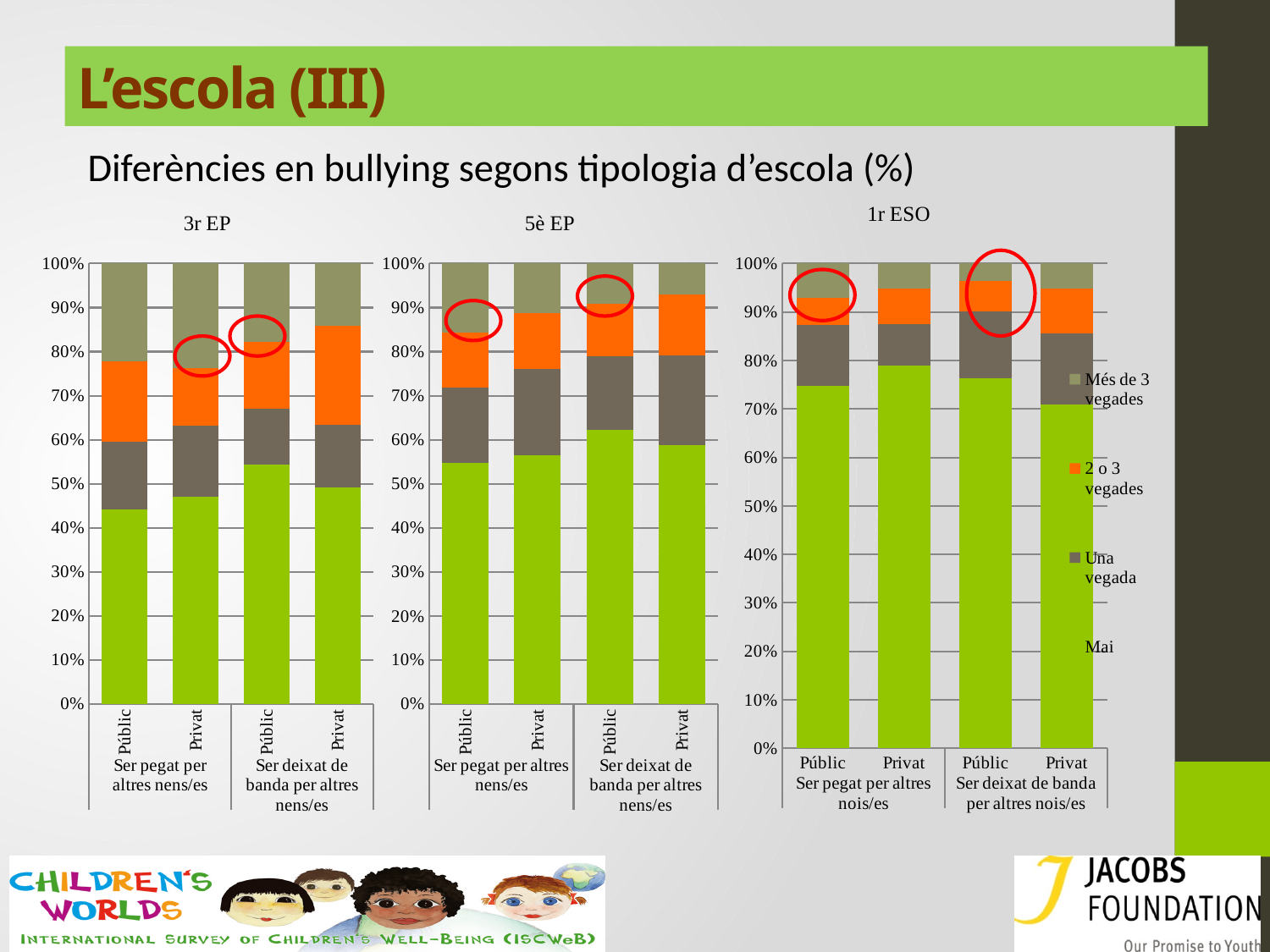
In the '5è EP' chart, is the 'Mai' value for Públic under 'Ser deixat de banda per altres nens/es' greater or less than 60%? greater What is the subtitle written above the three charts? Diferències en bullying segons tipologia d'escola (%) In the '1r ESO' chart, is the 'Mai' value for Públic under 'Ser pegat per altres nois/es' greater or less than 70%? greater What kind of chart is the '3r EP' chart? Stacked bar chart How many charts are shown on the slide? 3 In the '5è EP' chart, which has the larger 'Mai' segment: Públic under 'Ser pegat per altres nens/es' or Públic under 'Ser deixat de banda per altres nens/es'? Públic under 'Ser deixat de banda per altres nens/es' In the '3r EP' chart, is the 'Mai' value for Públic under 'Ser deixat de banda per altres nens/es' greater or less than 50%? greater In the '3r EP' chart, which has the larger 'Mai' segment under 'Ser deixat de banda per altres nens/es': Públic or Privat? Públic What are the four legend entries shown next to the '1r ESO' chart? Més de 3 vegades, 2 o 3 vegades, Una vegada, Mai How many bars are plotted in the '5è EP' chart? 4 How many series does the legend list? 4